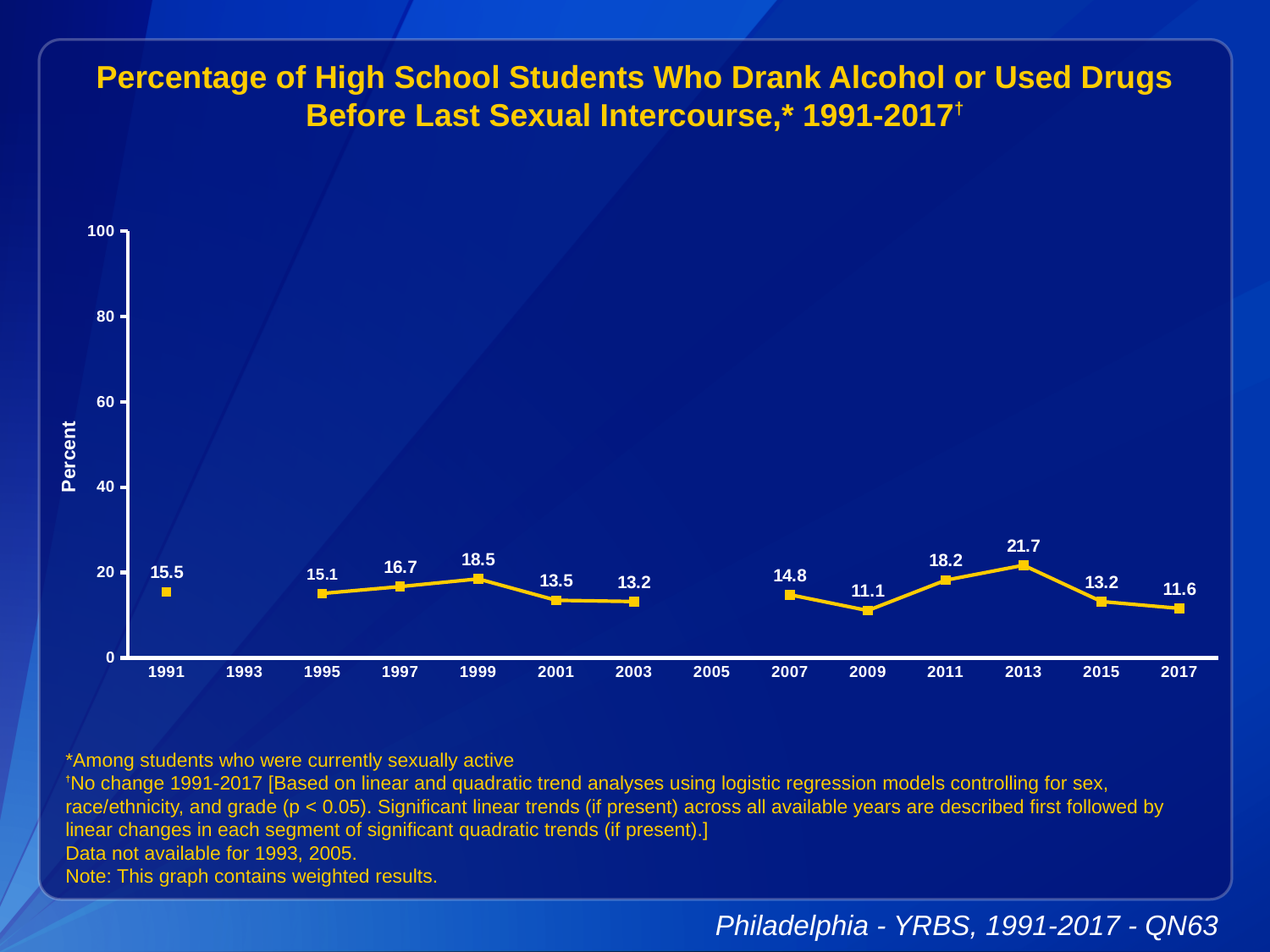
How many years have data points plotted? 12 What is the difference between the values for 2013 and 2009? 10.6 What is the value for 1991? 15.5 Which year has the highest value? 2013 Is the value for 2013 greater or less than 20? greater What is the value for 2009? 11.1 What kind of chart is this? line chart Which year has the lowest value? 2009 What is the label on the y axis? Percent What is the value for 2013? 21.7 Which is larger, the value for 1999 or the value for 2011? 1999 Do the values rise or fall from 2013 to 2017? fall